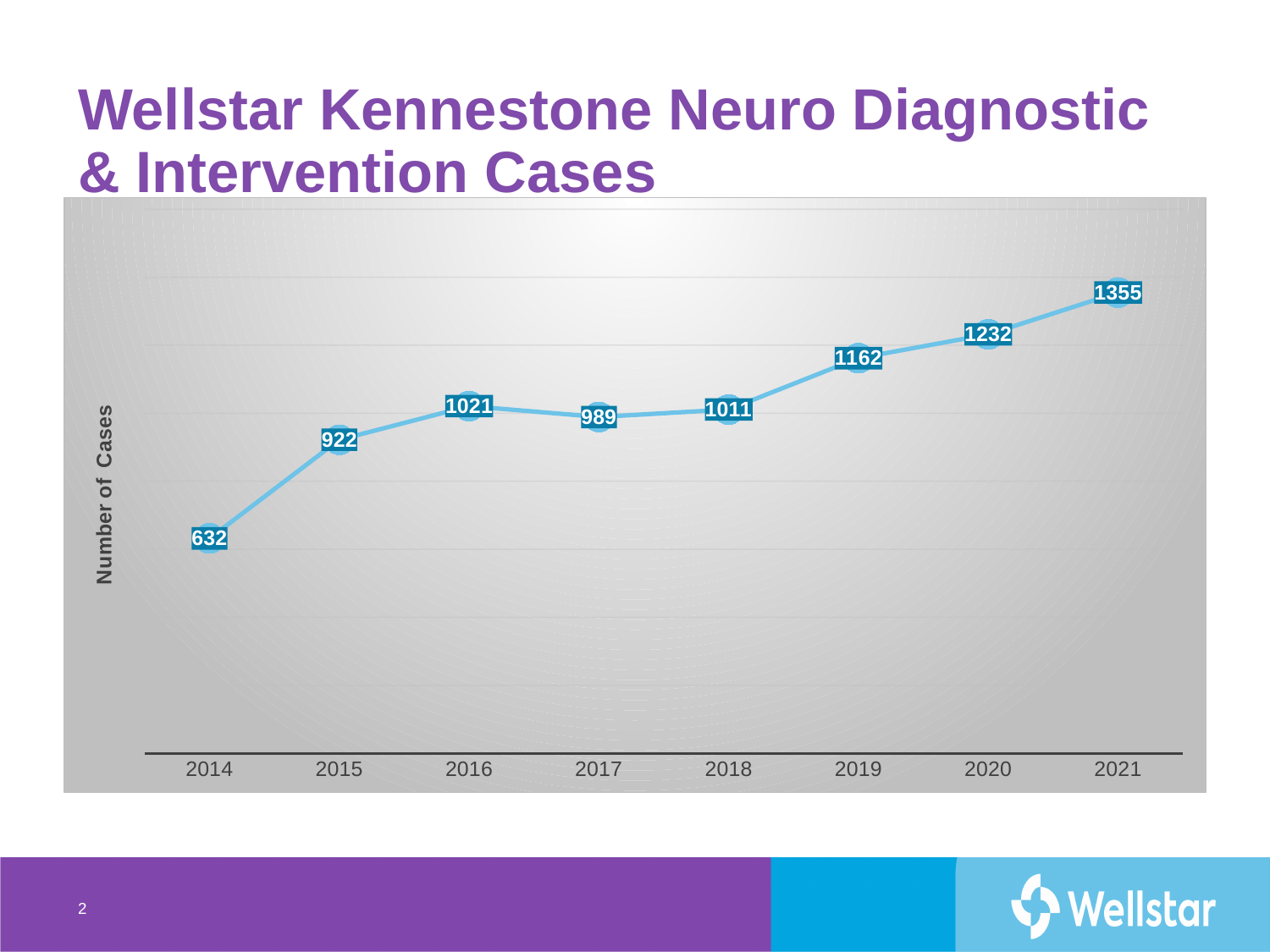
What is the number of cases in 2018? 1011 How many years are plotted on the chart? 8 What is the difference in the number of cases between 2016 and 2017? 32 What is the number of cases in 2021? 1355 Which year had more cases, 2019 or 2020? 2020 What is the number of cases in 2014? 632 What kind of chart is shown on the slide? Line chart Which year has the highest number of cases? 2021 What is the label of the vertical axis? Number of Cases Which year had more cases, 2016 or 2017? 2016 Which year has the lowest number of cases? 2014 What is the difference in the number of cases between 2021 and 2014? 723